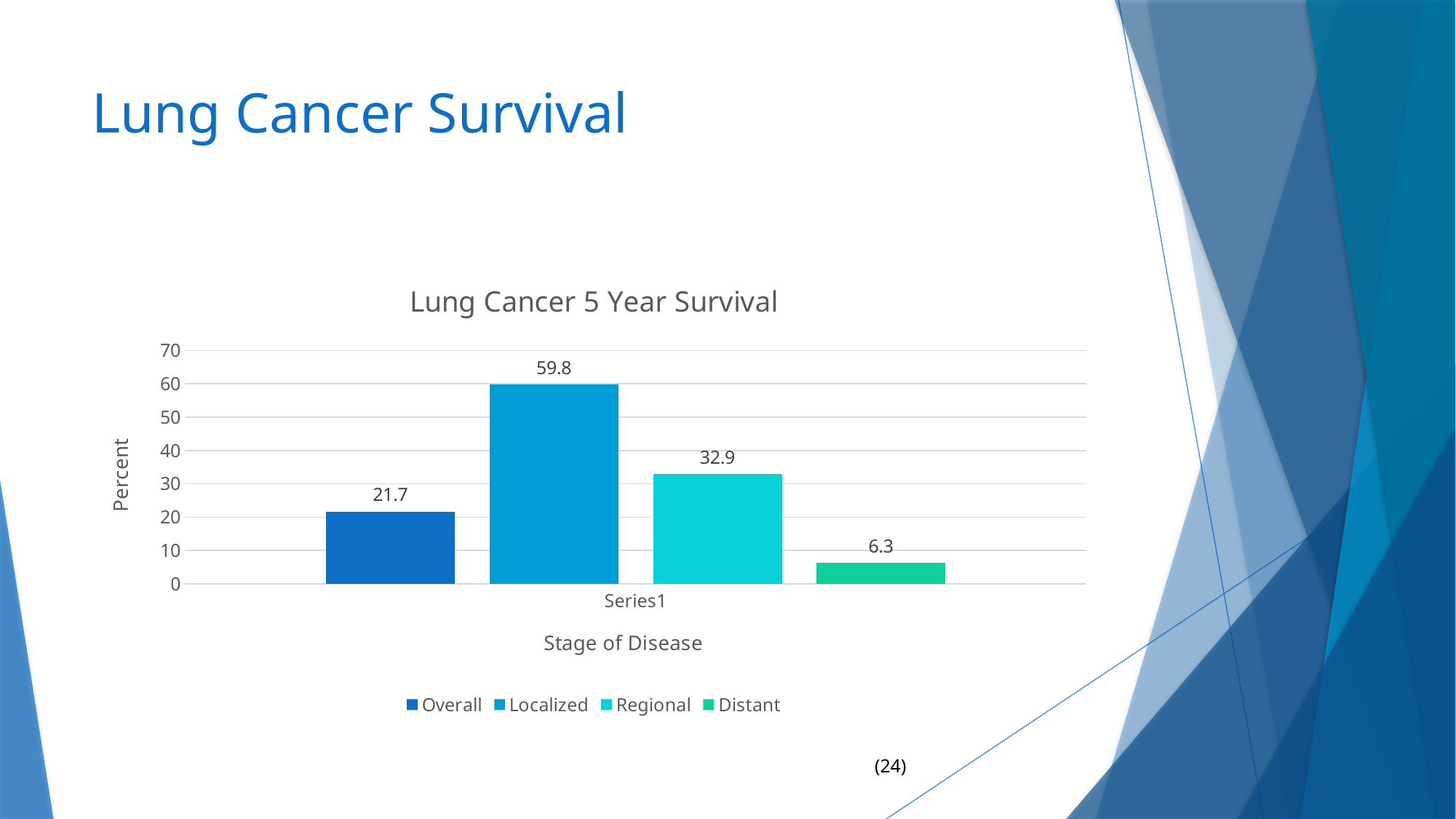
What is the value shown for the Distant series? 6.3 Which series has the highest 5-year survival value? Localized What is the value shown for the Overall series? 21.7 Is the value for Localized greater or less than 50? greater How many series does the legend list? 4 What is the difference between the Localized and Regional values? 26.9 Which is larger, the Overall value or the Regional value? Regional What is the value shown for the Regional series? 32.9 Which series has the lowest 5-year survival value? Distant What is the title of the chart? Lung Cancer 5 Year Survival What kind of chart is shown on the slide? Bar chart What is the 5-year survival percentage for Localized lung cancer? 59.8